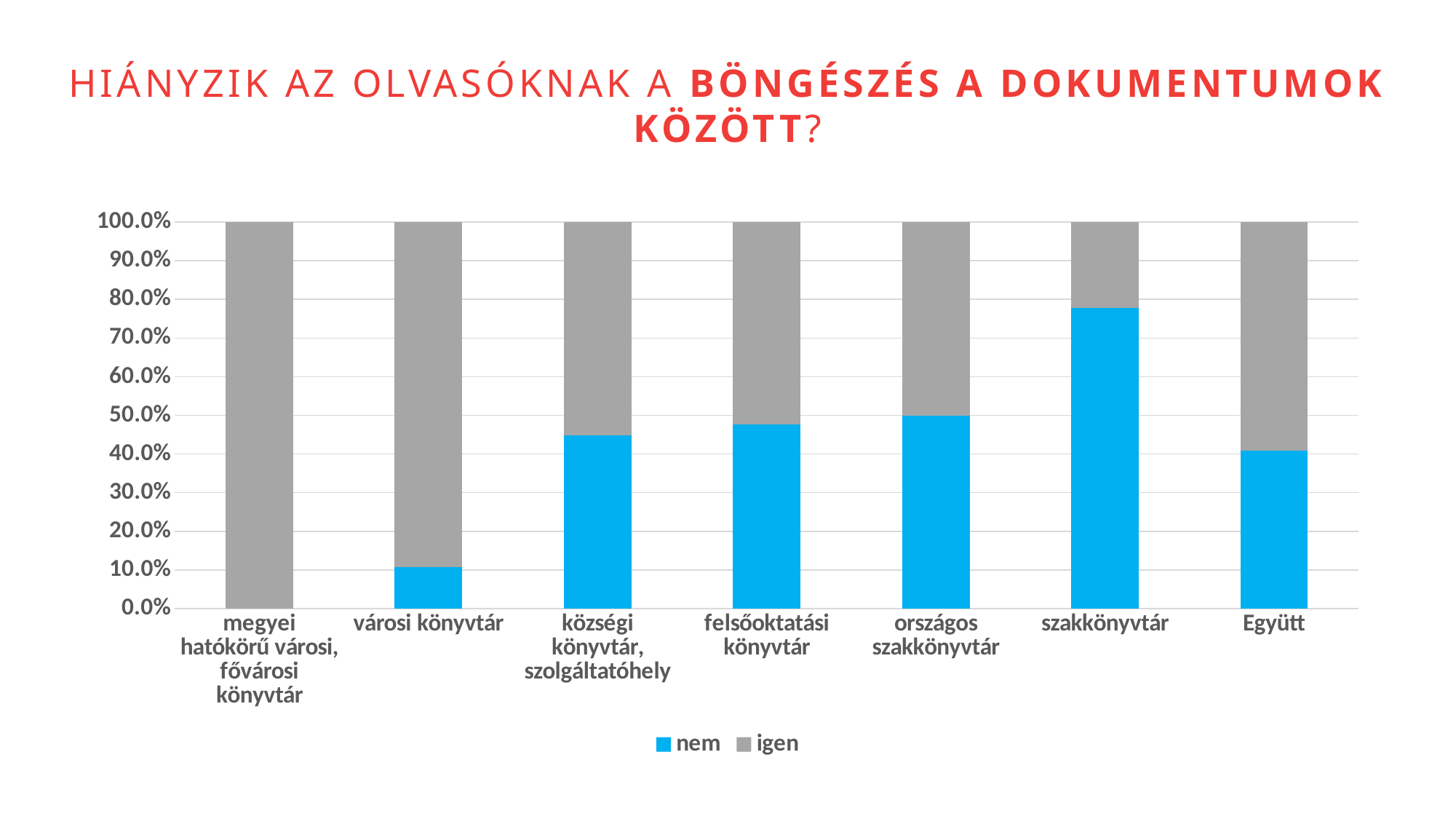
Is the 'nem' value for szakkönyvtár greater or less than 70.0%? greater What kind of chart is shown on the slide? stacked bar chart How many series does the legend list? 2 Which category has the highest value for the 'igen' series? megyei hatókörű városi, fővárosi könyvtár Which category has the lowest value for the 'nem' series? megyei hatókörű városi, fővárosi könyvtár Which category has the highest value for the 'nem' series? szakkönyvtár Which has a larger 'nem' value: szakkönyvtár or Együtt? szakkönyvtár Is the 'nem' value for városi könyvtár greater or less than 20.0%? less What colour represents the 'igen' series in the chart? grey How many categories are shown on the x axis of the chart? 7 Which has a larger 'nem' value: városi könyvtár or községi könyvtár, szolgáltatóhely? községi könyvtár, szolgáltatóhely Is the 'nem' value for Együtt greater or less than 30.0%? greater